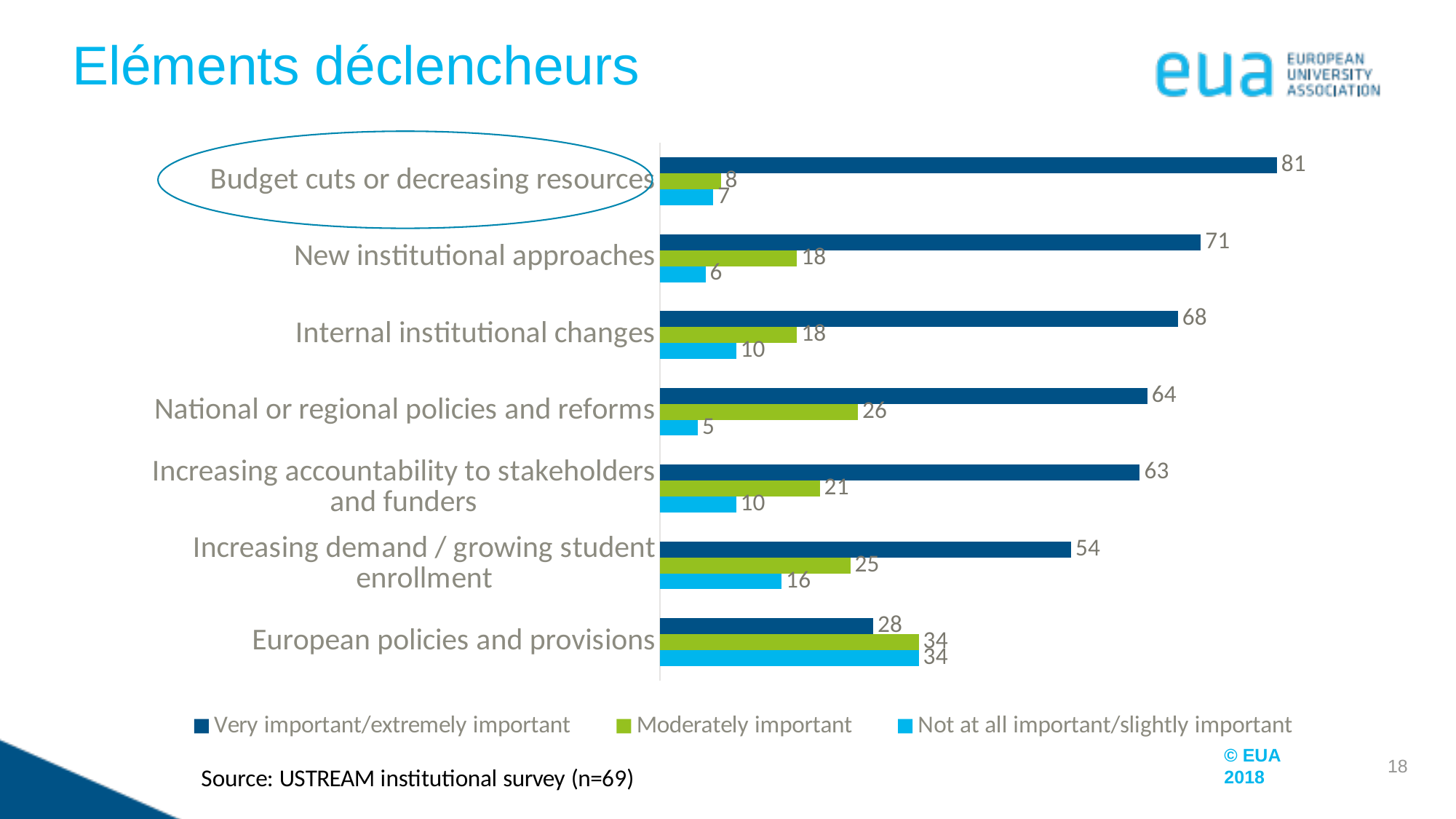
How many categories are shown on the chart? 7 Which category has the highest 'Very important/extremely important' value? Budget cuts or decreasing resources What kind of chart is shown on the slide? Bar chart What is the value for 'Not at all important/slightly important' for Increasing demand / growing student enrollment? 16 What is the value for 'Very important/extremely important' for Budget cuts or decreasing resources? 81 How many series does the legend list? 3 What is the total of the three values for European policies and provisions? 96 Which category on the chart is circled? Budget cuts or decreasing resources Which category has the lowest 'Very important/extremely important' value? European policies and provisions What is the difference between the 'Very important/extremely important' values for New institutional approaches and Internal institutional changes? 3 Which is larger: the 'Moderately important' value for Increasing accountability to stakeholders and funders or for Increasing demand / growing student enrollment? Increasing demand / growing student enrollment What is the value for 'Moderately important' for National or regional policies and reforms? 26